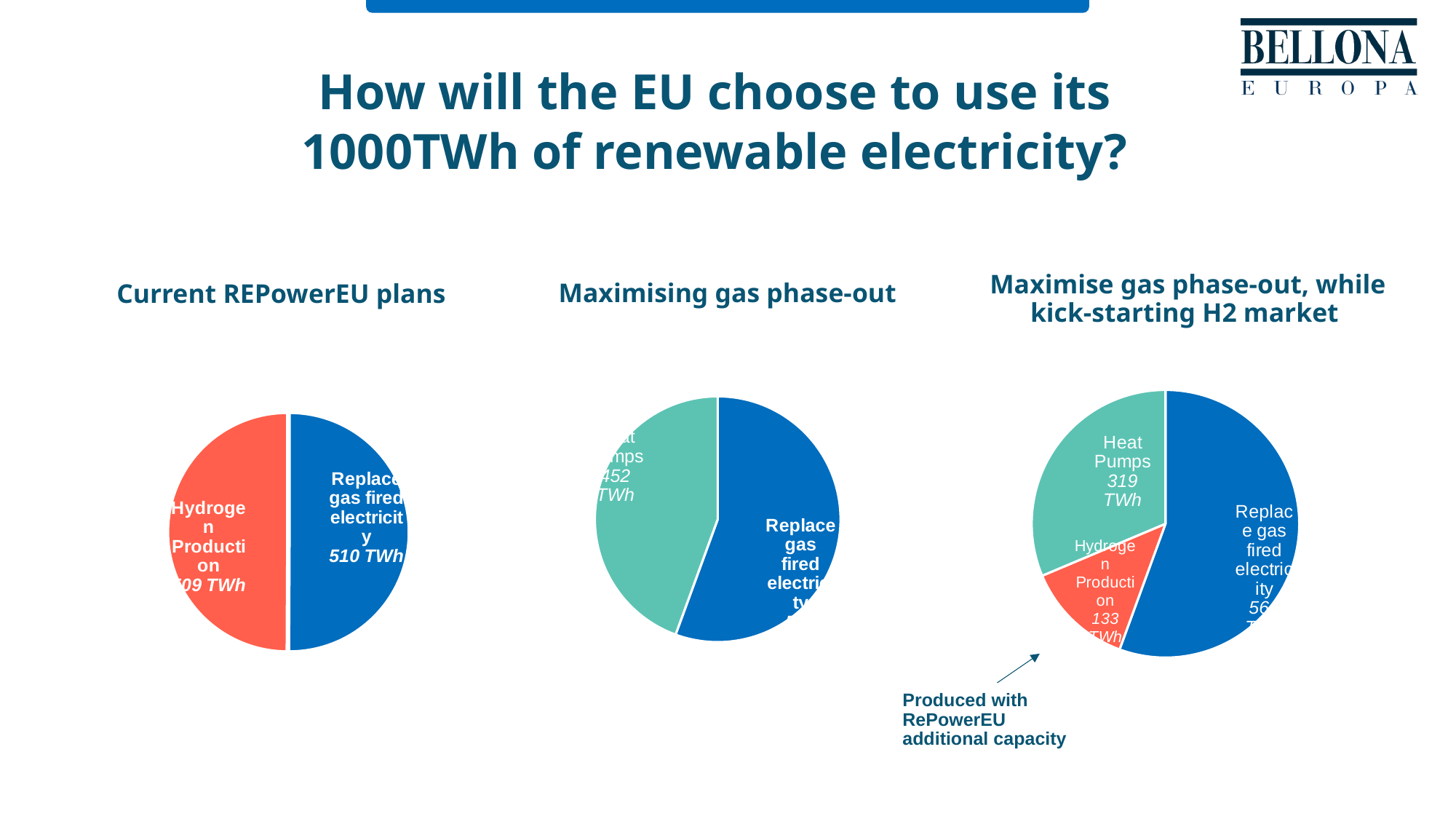
How many slices does the 'Maximising gas phase-out' pie chart have? 2 In the 'Maximise gas phase-out, while kick-starting H2 market' chart, how much larger is Heat Pumps than Hydrogen Production? 186 TWh In the 'Maximise gas phase-out, while kick-starting H2 market' chart, which slice is the smallest? Hydrogen Production In the 'Maximise gas phase-out, while kick-starting H2 market' chart, what value is shown for Hydrogen Production? 133 TWh What kind of chart is the 'Current REPowerEU plans' chart? Pie chart How many slices does the 'Maximise gas phase-out, while kick-starting H2 market' pie chart have? 3 How many slices does the 'Current REPowerEU plans' pie chart have? 2 In the 'Maximising gas phase-out' chart, which slice is larger: Heat Pumps or Replace gas fired electricity? Replace gas fired electricity In the 'Maximise gas phase-out, while kick-starting H2 market' chart, which slice is the largest? Replace gas fired electricity In the 'Maximising gas phase-out' chart, what value is shown for Heat Pumps? 452 TWh In the 'Current REPowerEU plans' chart, what value is shown for Replace gas fired electricity? 510 TWh In the 'Maximise gas phase-out, while kick-starting H2 market' chart, what value is shown for Heat Pumps? 319 TWh